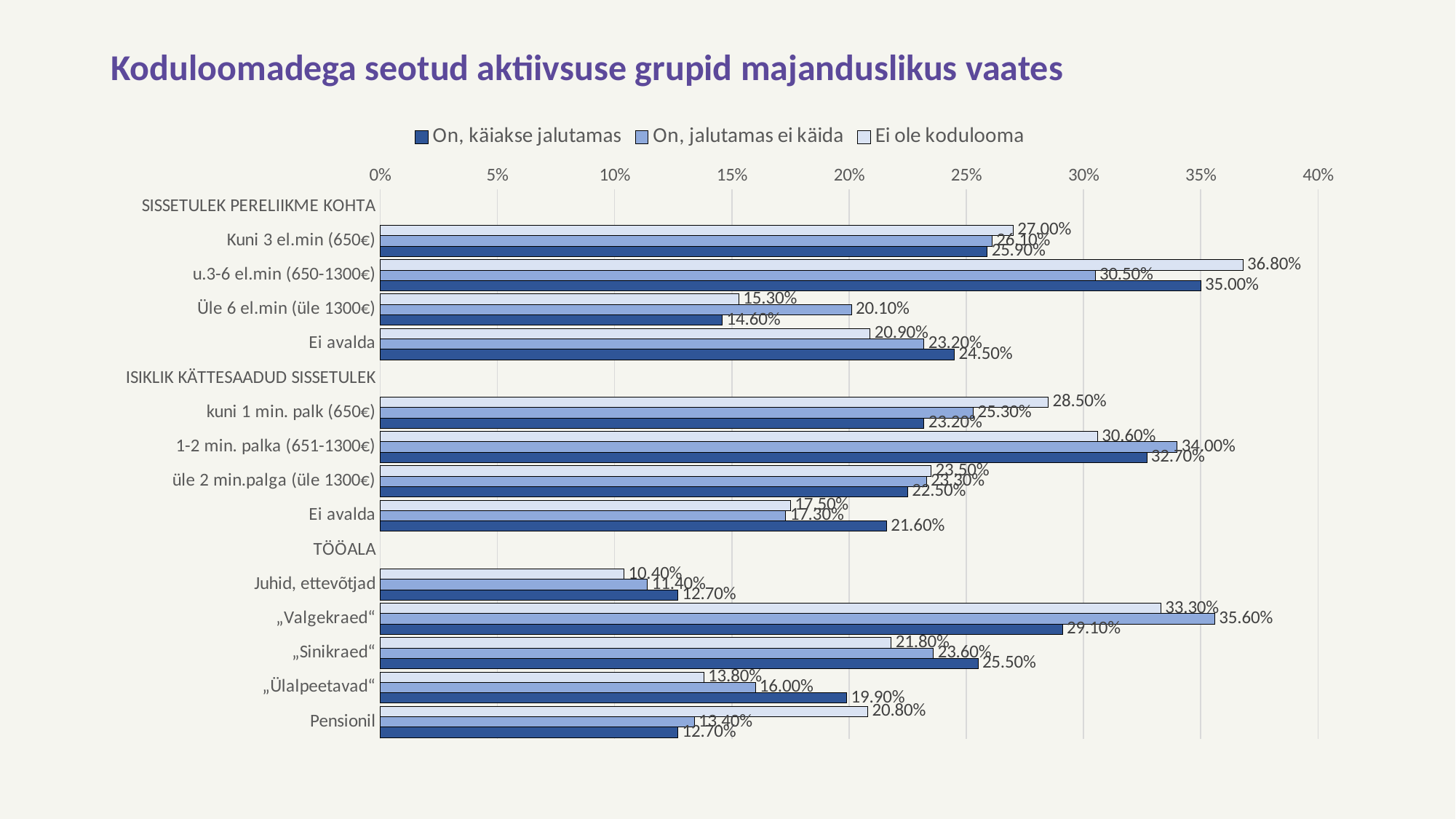
What type of chart is shown on the slide? bar chart Which category under TÖÖALA has the lowest value for "Ei ole kodulooma"? Juhid, ettevõtjad How many series does the legend list? 3 For "Üle 6 el.min (üle 1300€)", which is larger: "On, jalutamas ei käida" or "On, käiakse jalutamas"? On, jalutamas ei käida What is the title of the chart? Koduloomadega seotud aktiivsuse grupid majanduslikus vaates Which category under TÖÖALA has the highest value for "On, käiakse jalutamas"? „Valgekraed“ What is the difference between the "On, jalutamas ei käida" and "Ei ole kodulooma" values for "1-2 min. palka (651-1300€)"? 3.40% What is the value for "Ei ole kodulooma" in the category "u.3-6 el.min (650-1300€)"? 36.80% What is the difference between the "Ei ole kodulooma" and "On, käiakse jalutamas" values for "Pensionil"? 8.10% What is the value for "On, jalutamas ei käida" in the category "„Valgekraed“"? 35.60% What is the value for "On, käiakse jalutamas" in the category "Pensionil"? 12.70% Is the value for "On, käiakse jalutamas" in "u.3-6 el.min (650-1300€)" greater or less than 30%? greater